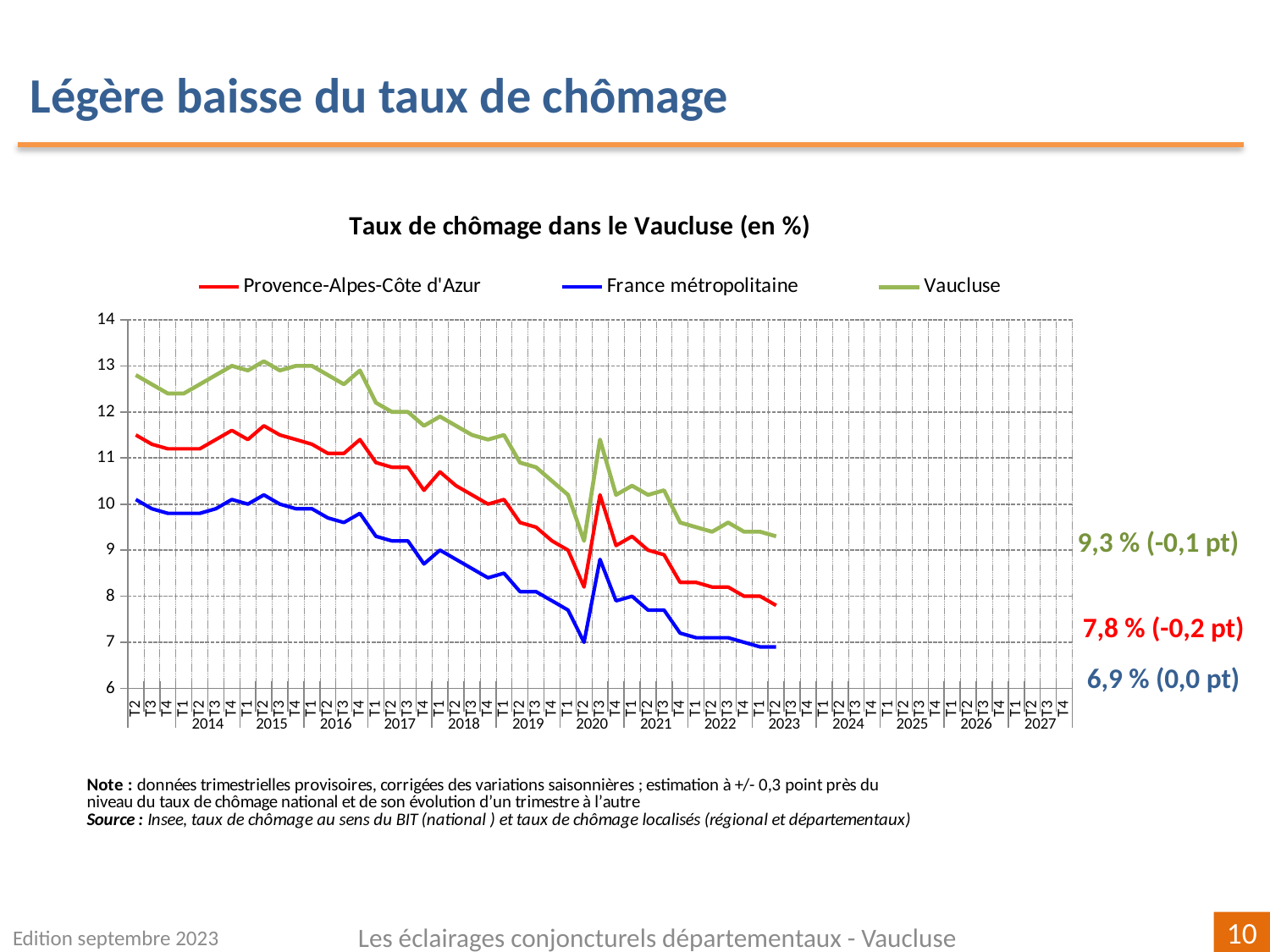
What is the difference between the latest Vaucluse rate and the latest France métropolitaine rate? 2,4 points By how many points did the Vaucluse unemployment rate change in the latest quarter, according to the label? -0,1 pt Is the Vaucluse unemployment rate in T2 2014 greater or less than 12? greater Which series has the lowest unemployment rate at the end of the period? France métropolitaine What kind of chart is shown on the slide? Line chart What is the latest unemployment rate shown for France métropolitaine? 6,9 % Which series has the highest unemployment rate at the end of the period? Vaucluse How many series does the legend list? 3 What is the difference between the latest Provence-Alpes-Côte d'Azur rate and the latest France métropolitaine rate? 0,9 point Overall, do the unemployment rates rise or fall from 2014 to 2023? Fall What is the latest unemployment rate shown for Provence-Alpes-Côte d'Azur? 7,8 % What is the latest unemployment rate shown for Vaucluse? 9,3 %